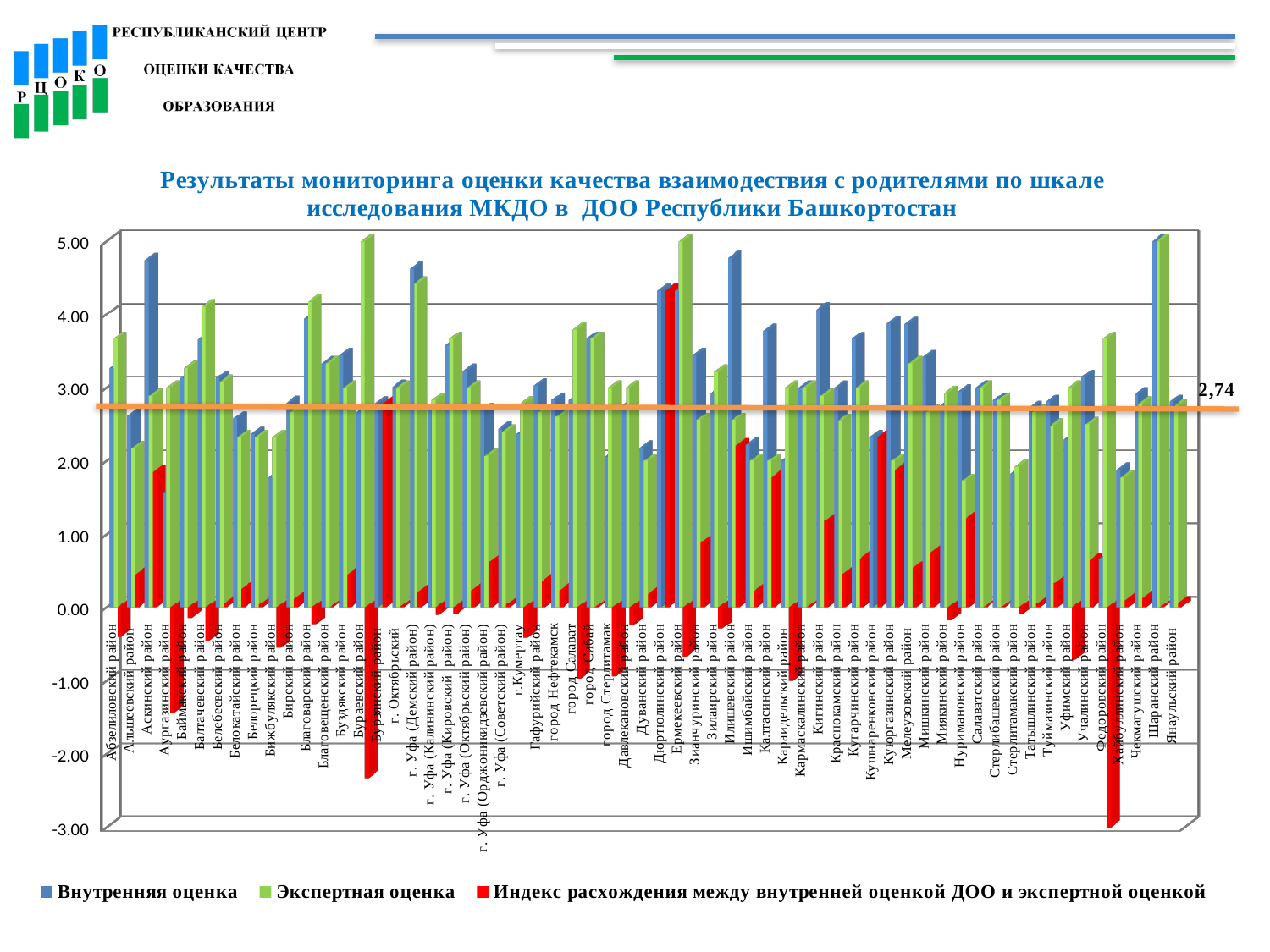
Which category has the highest value for Индекс расхождения между внутренней оценкой ДОО и экспертной оценкой? Дюртюлинский район Which series is shown in green according to the legend? Экспертная оценка What kind of chart is shown on the slide? bar chart Is the value of Индекс расхождения между внутренней оценкой ДОО и экспертной оценкой for Федоровский район greater or less than -2.00? less For Бураевский район, which is larger: Внутренняя оценка or Экспертная оценка? Экспертная оценка How many series does the legend list? 3 What value is printed next to the horizontal orange reference line on the chart? 2,74 Is the value of Экспертная оценка for Бураевский район greater or less than 4.00? greater Which category has the lowest value for Индекс расхождения между внутренней оценкой ДОО и экспертной оценкой? Федоровский район Which series is shown in red according to the legend? Индекс расхождения между внутренней оценкой ДОО и экспертной оценкой For Аскинский район, which is larger: Внутренняя оценка or Экспертная оценка? Внутренняя оценка Is the value of Внутренняя оценка for Аскинский район greater or less than 4.00? greater